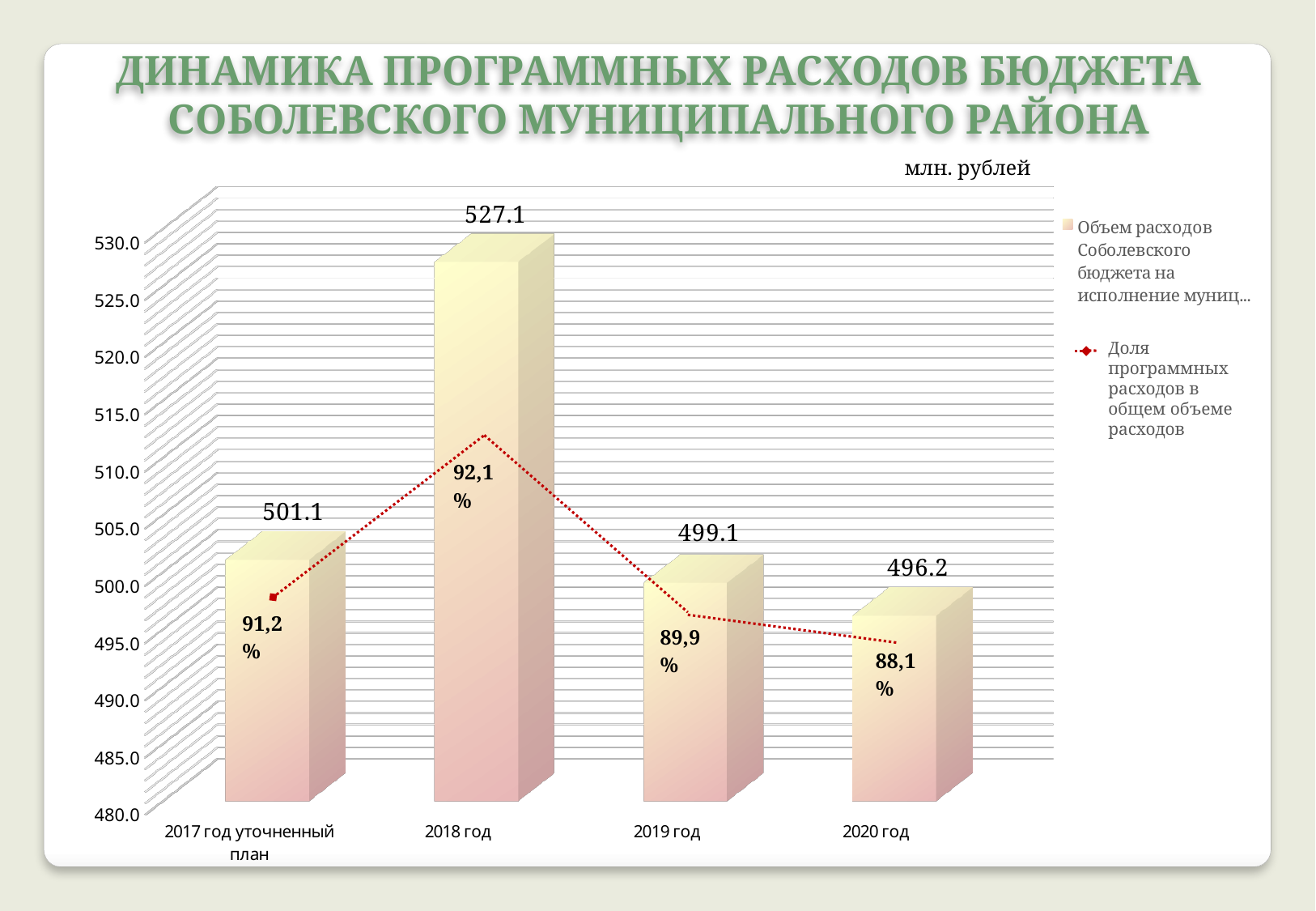
How many series does the legend list? 2 Which year has the lowest share of programme expenditures? 2020 год What is the volume of expenditures for 2020 год? 496.2 Which year has the highest volume of expenditures? 2018 год What is the share of programme expenditures (Доля программных расходов) for 2019 год? 89,9 % Does the share of programme expenditures rise or fall from 2018 год to 2020 год? fall Which is larger, the expenditure volume for 2017 год уточненный план or for 2019 год? 2017 год уточненный план How many categories (years) are shown on the x axis? 4 What is the difference in expenditure volume between 2018 год and 2019 год? 28.0 What unit is indicated above the chart for the bar values? млн. рублей What is the volume of expenditures (млн. рублей) for 2018 год? 527.1 What is the share of programme expenditures for 2017 год уточненный план? 91,2 %